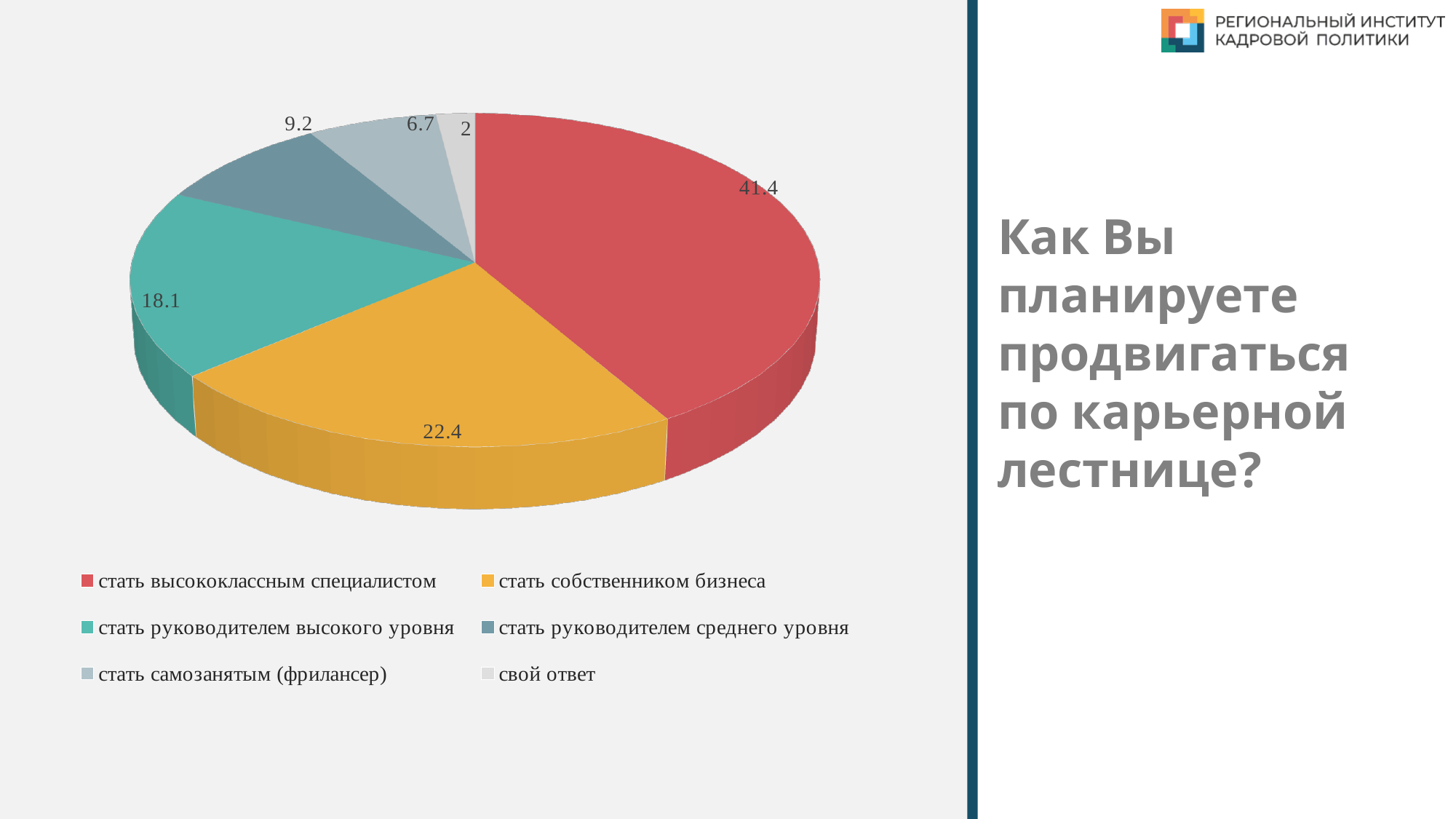
What is the difference between the values for "стать высококлассным специалистом" and "стать собственником бизнеса"? 19 What value is shown for "стать самозанятым (фрилансер)"? 6.7 What value is shown for "стать высококлассным специалистом"? 41.4 What is the difference between the values for "стать руководителем высокого уровня" and "стать руководителем среднего уровня"? 8.9 Which is larger: the value for "стать руководителем среднего уровня" or for "стать самозанятым (фрилансер)"? стать руководителем среднего уровня What value is shown for "стать руководителем высокого уровня"? 18.1 How many slices does the pie chart have? 6 What colour is the slice for "стать собственником бизнеса"? yellow Which category has the smallest slice of the pie? свой ответ Which category has the largest slice of the pie? стать высококлассным специалистом What kind of chart is shown on the slide? pie chart What value is shown for "стать собственником бизнеса"? 22.4